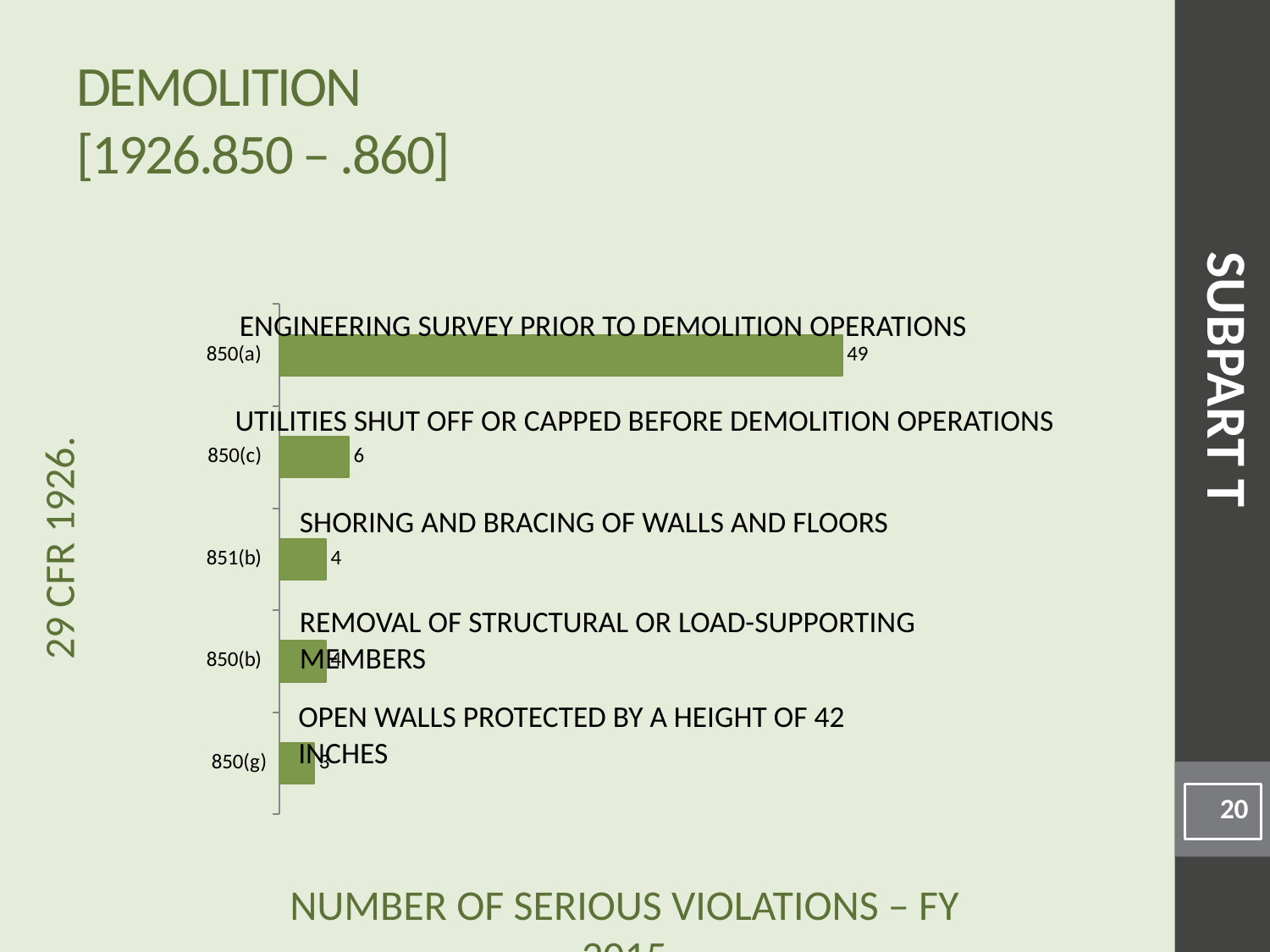
What is the number of serious violations for 851(b)? 4 Which standard is described as 'ENGINEERING SURVEY PRIOR TO DEMOLITION OPERATIONS'? 850(a) Which has more serious violations, 850(c) or 851(b)? 850(c) What is the number of serious violations for 850(c)? 6 What is the difference between the values for 850(c) and 851(b)? 2 What is the number of serious violations for 850(a)? 49 Which category has the lowest number of serious violations? 850(g) How many categories are shown in the chart? 5 What is the difference between the values for 850(a) and 850(c)? 43 What kind of chart is shown on the slide? Bar chart Which category has the highest number of serious violations? 850(a) Which has more serious violations, 850(a) or 850(g)? 850(a)